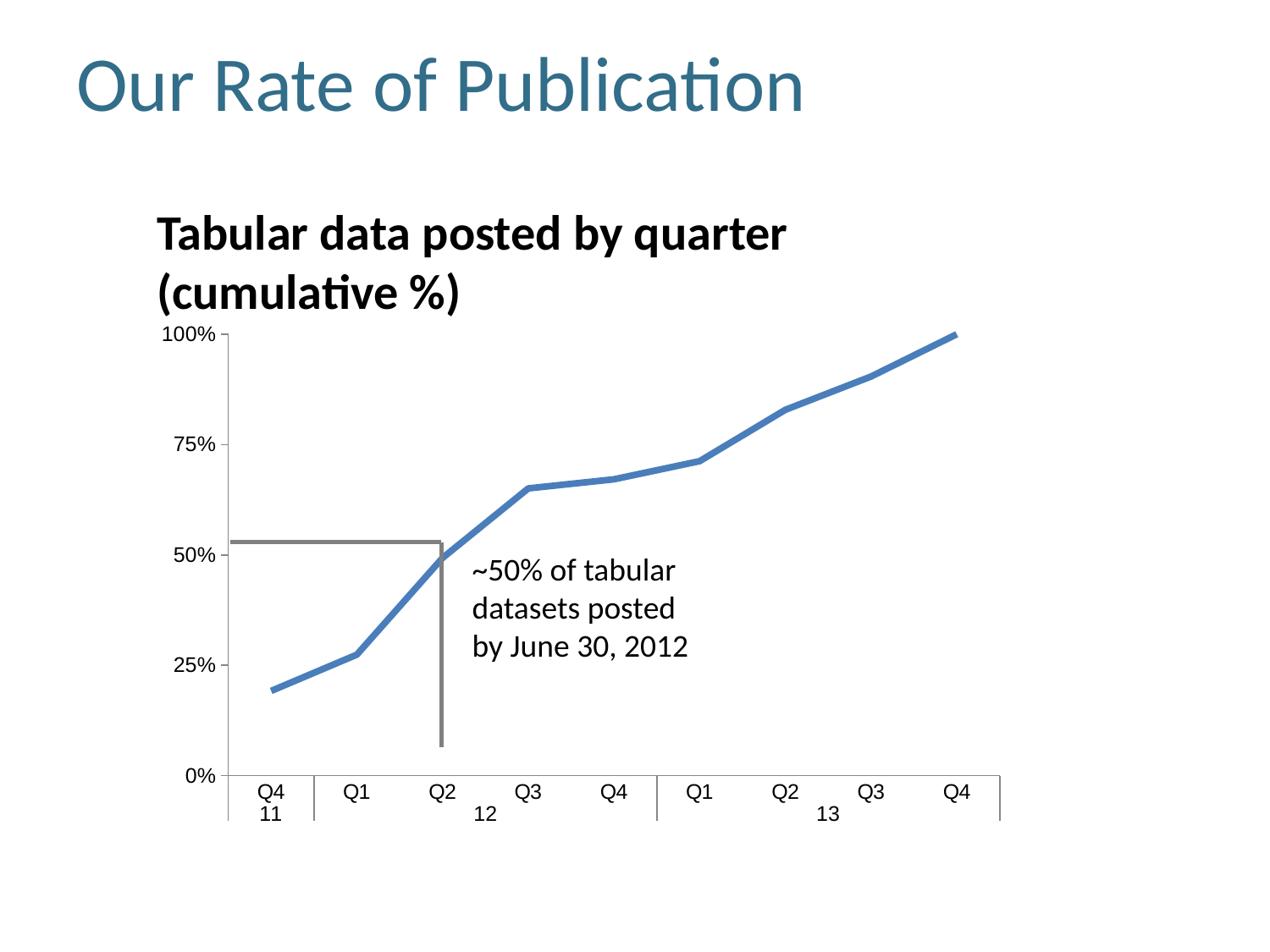
What is the title of the chart? Tabular data posted by quarter (cumulative %) Is the value for Q4 12 greater or less than 75%? less Which quarter has the highest value? Q4 13 Is the value for Q3 12 greater or less than 50%? greater How many quarters are plotted on the x axis? 9 Which is larger, the value for Q1 12 or the value for Q3 12? Q3 12 Is the value for Q2 13 greater or less than 75%? greater What kind of chart is shown on the slide? line chart Which quarter has the lowest value? Q4 11 Do the values rise or fall from Q4 11 to Q4 13? rise What is the value for Q4 13? 100%